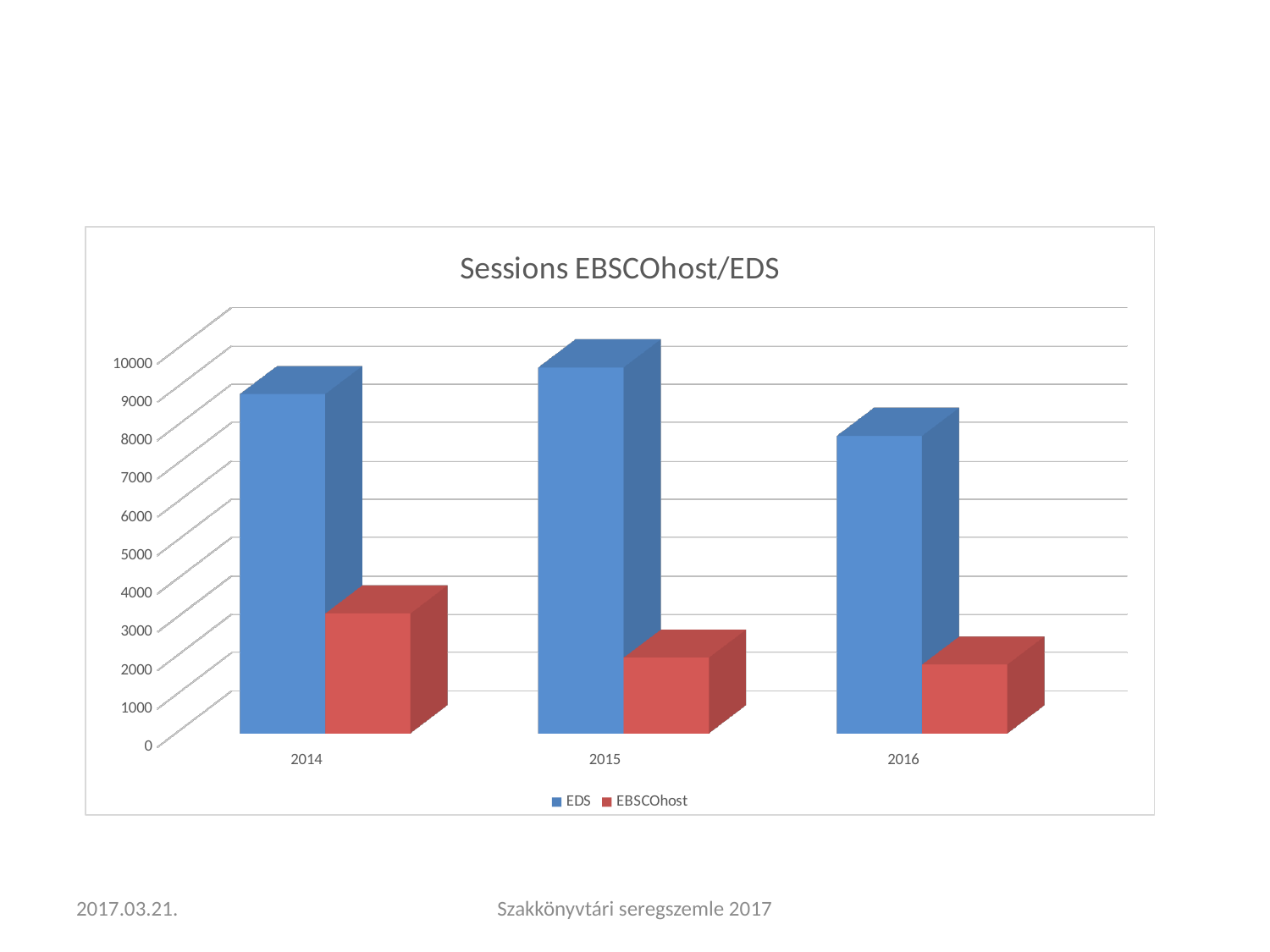
What is the title of the chart? Sessions EBSCOhost/EDS In which year is the EBSCOhost value highest? 2014 Which series has the larger value in 2016, EDS or EBSCOhost? EDS Is the EBSCOhost value for 2014 greater or less than 4000? less How many series does the legend list? 2 How many years are shown on the x axis? 3 Is the EDS value for 2015 greater or less than 9000? greater Which series is shown in red? EBSCOhost Do the EBSCOhost values rise or fall from 2014 to 2016? fall In which year is the EDS value lowest? 2016 What kind of chart is shown on the slide? bar chart In which year is the EDS value highest? 2015